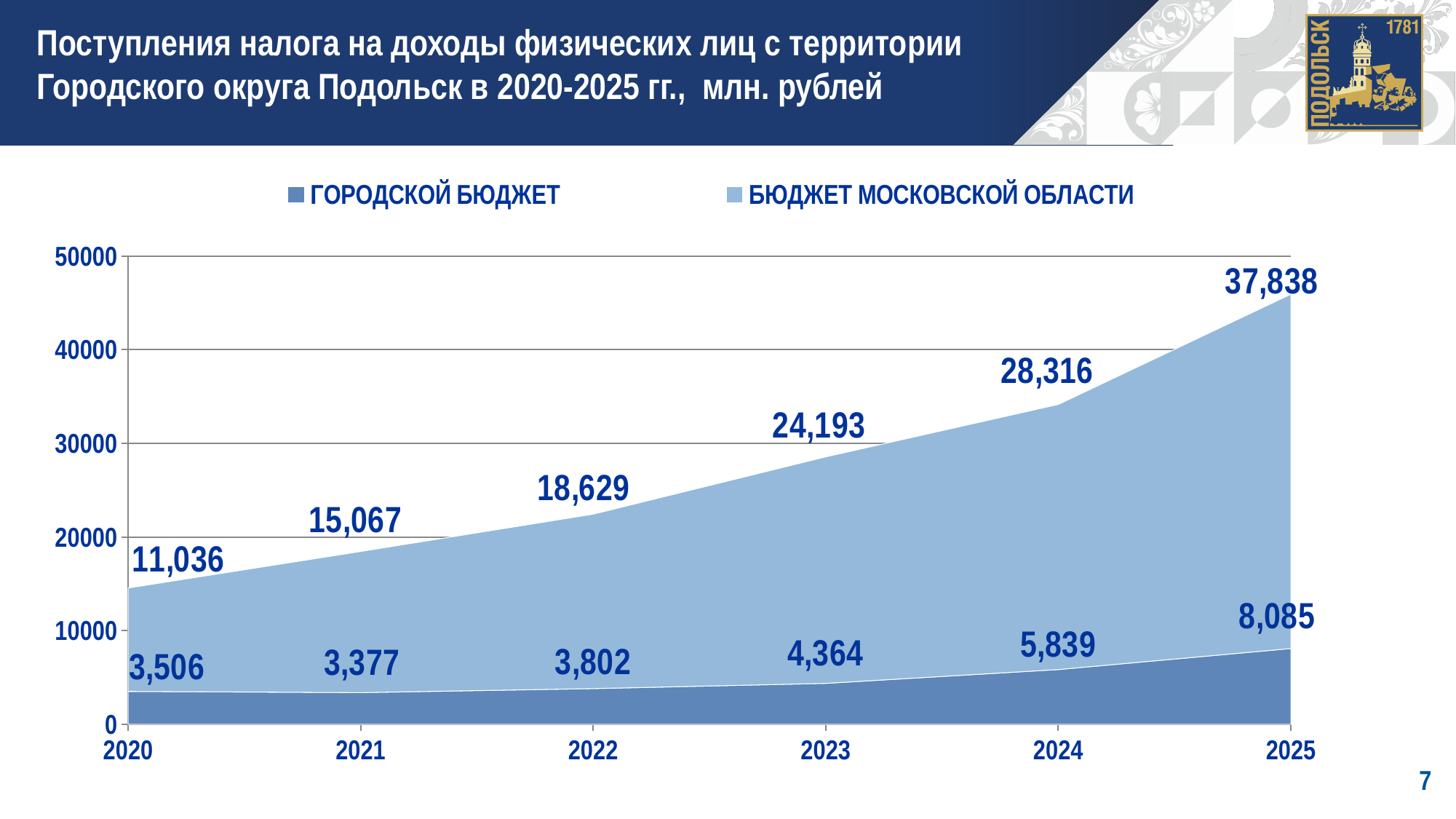
What is the value for ГОРОДСКОЙ БЮДЖЕТ in 2021? 3,377 How many years are shown on the x axis? 6 How many series does the legend list? 2 What is the value for БЮДЖЕТ МОСКОВСКОЙ ОБЛАСТИ in 2022? 18,629 Does the value for БЮДЖЕТ МОСКОВСКОЙ ОБЛАСТИ rise or fall from 2020 to 2025? Rise What kind of chart is shown on the slide? Stacked area chart In which year is the value for ГОРОДСКОЙ БЮДЖЕТ the lowest? 2021 What is the value for ГОРОДСКОЙ БЮДЖЕТ in 2025? 8,085 In which year is the value for БЮДЖЕТ МОСКОВСКОЙ ОБЛАСТИ the highest? 2025 What is the combined total of ГОРОДСКОЙ БЮДЖЕТ and БЮДЖЕТ МОСКОВСКОЙ ОБЛАСТИ for 2020? 14,542 Which is larger: the ГОРОДСКОЙ БЮДЖЕТ value for 2023 or for 2024? 2024 What is the difference between the БЮДЖЕТ МОСКОВСКОЙ ОБЛАСТИ values for 2025 and 2024? 9,522